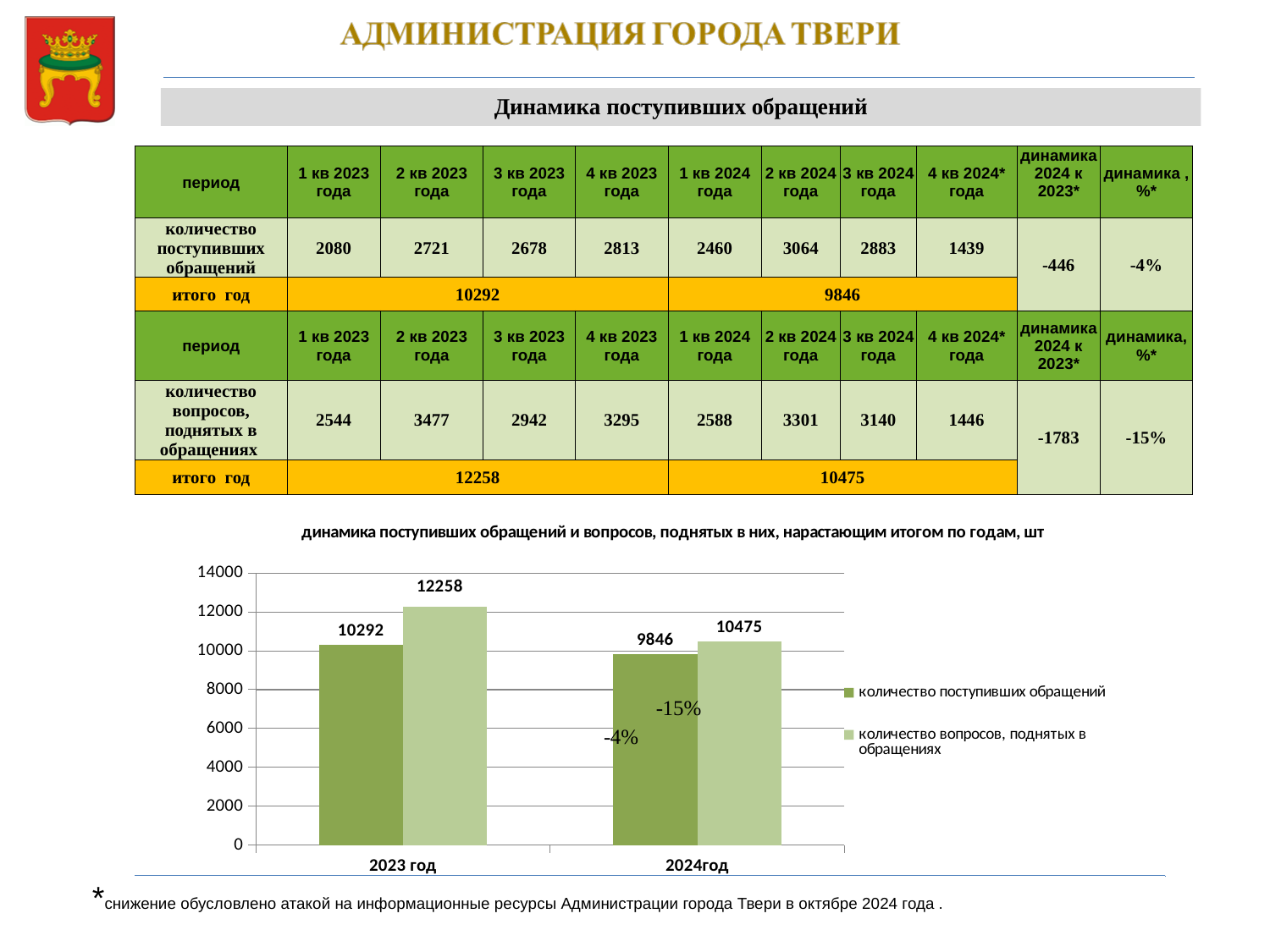
What is the difference between "количество поступивших обращений" in 2023 год and in 2024год? 446 What is the value of "количество вопросов, поднятых в обращениях" for 2024год? 10475 What is the value of "количество поступивших обращений" for 2024год? 9846 Which bar in the chart has the lowest value? количество поступивших обращений, 2024год Which is larger: "количество поступивших обращений" in 2023 год or "количество вопросов, поднятых в обращениях" in 2024год? количество вопросов, поднятых в обращениях in 2024год How many series does the chart legend list? 2 What is the difference between "количество вопросов, поднятых в обращениях" in 2023 год and in 2024год? 1783 What is the value of "количество поступивших обращений" for 2023 год? 10292 What type of chart is shown on the slide? bar chart Which bar in the chart has the highest value? количество вопросов, поднятых в обращениях, 2023 год Does "количество поступивших обращений" rise or fall from 2023 год to 2024год? fall What is the value of "количество вопросов, поднятых в обращениях" for 2023 год? 12258